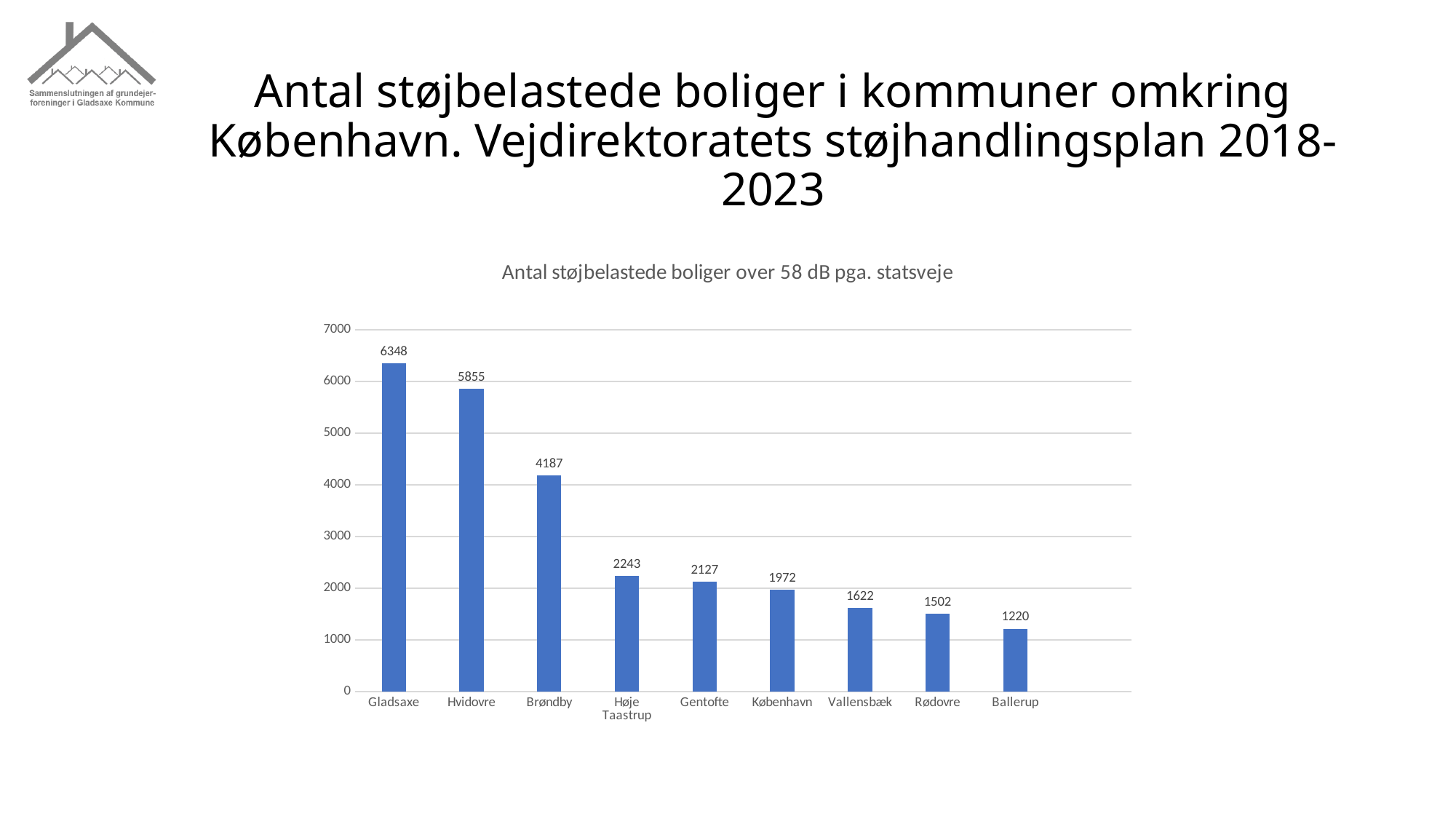
What is the difference between the values for Gladsaxe and Hvidovre? 493 What is the difference between the values for Brøndby and Ballerup? 2967 Which municipality has the lowest value? Ballerup What is the value for Gladsaxe? 6348 How many municipalities are shown on the x axis? 9 Which is larger, the value for Gentofte or the value for København? Gentofte What kind of chart is shown on the slide? bar chart What is the value for Høje Taastrup? 2243 What is the title of the chart? Antal støjbelastede boliger over 58 dB pga. statsveje What is the value for Rødovre? 1502 Which municipality has the highest value? Gladsaxe Is the value for Vallensbæk greater or less than 2000? less